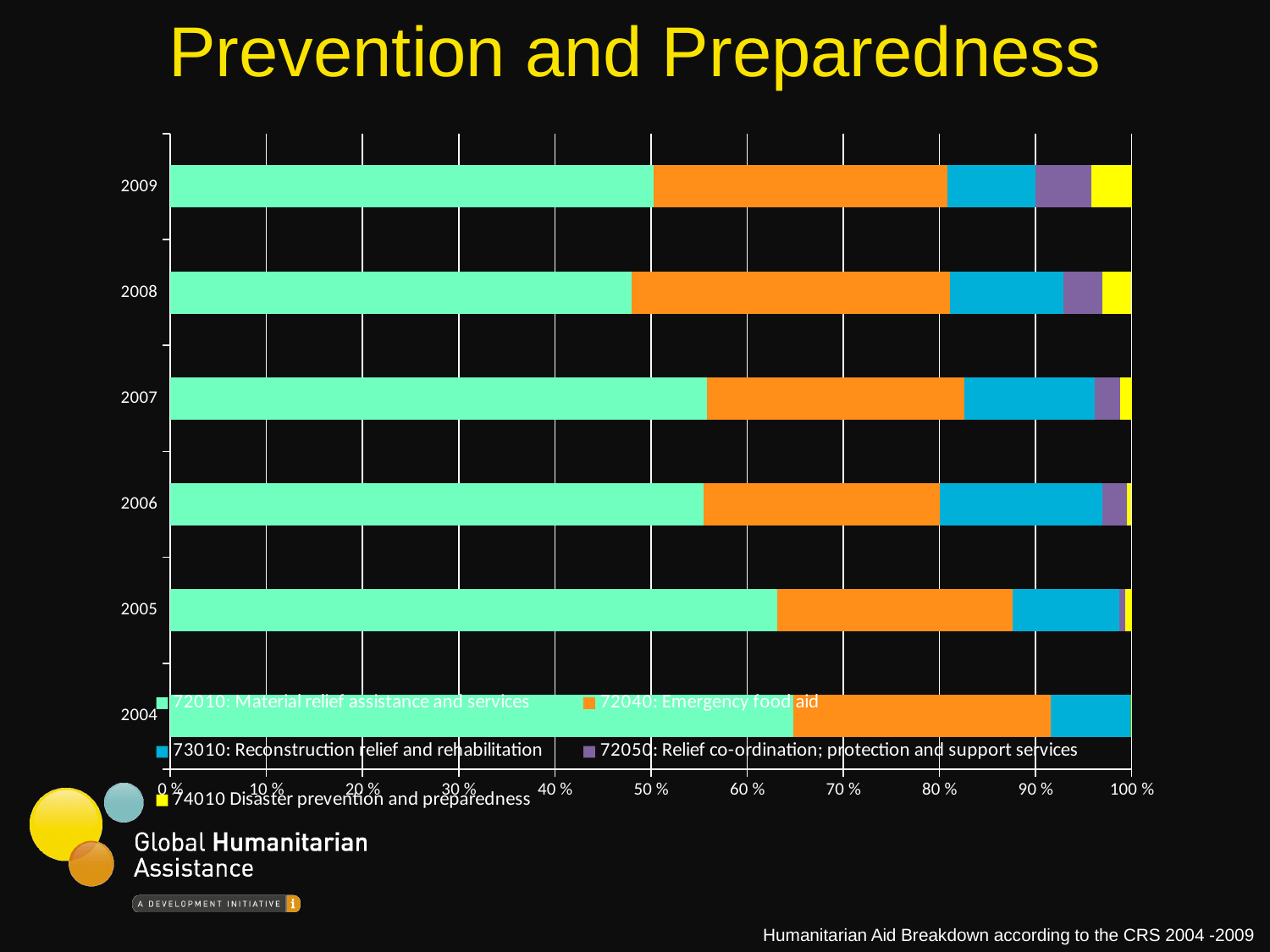
Does the share for 74010 Disaster prevention and preparedness generally rise or fall from 2004 to 2009? rise Which year has the larger share for 73010: Reconstruction relief and rehabilitation, 2004 or 2006? 2006 Which year has the larger share for 72010: Material relief assistance and services, 2004 or 2009? 2004 Is the share for 72010: Material relief assistance and services in 2007 greater or less than 50%? greater Is the share for 72010: Material relief assistance and services in 2008 greater or less than 50%? less What kind of chart is shown on the slide? Stacked bar chart Which series is shown in yellow in the chart legend? 74010 Disaster prevention and preparedness How many series does the chart legend list? 5 What is the title of the slide? Prevention and Preparedness Is the share for 72010: Material relief assistance and services in 2004 greater or less than 60%? greater How many years are shown on the vertical axis of the chart? 6 Which year has the larger share for 74010 Disaster prevention and preparedness, 2005 or 2009? 2009